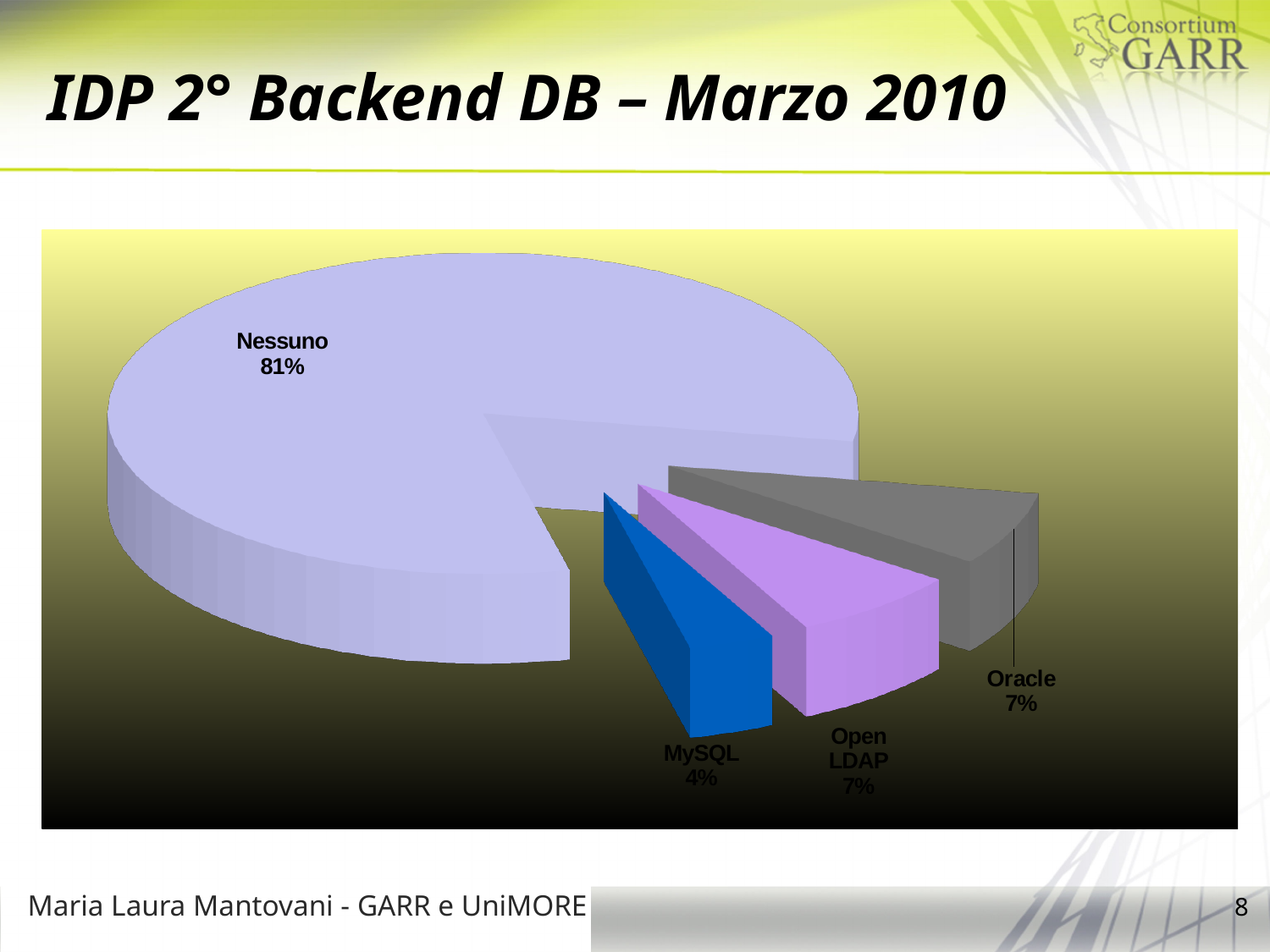
How many slices does the pie chart have? 4 What share of the pie does Oracle have? 7% What share of the pie does Open LDAP have? 7% What share of the pie does MySQL have? 4% What is the title of the slide containing the pie chart? IDP 2° Backend DB – Marzo 2010 What is the difference in percentage points between Nessuno and Oracle? 74 Which category has the largest slice of the pie? Nessuno Which is larger, the share for Oracle or the share for MySQL? Oracle What is the difference in percentage points between Open LDAP and MySQL? 3 Which category has the smallest slice of the pie? MySQL What kind of chart is shown on the slide? pie chart